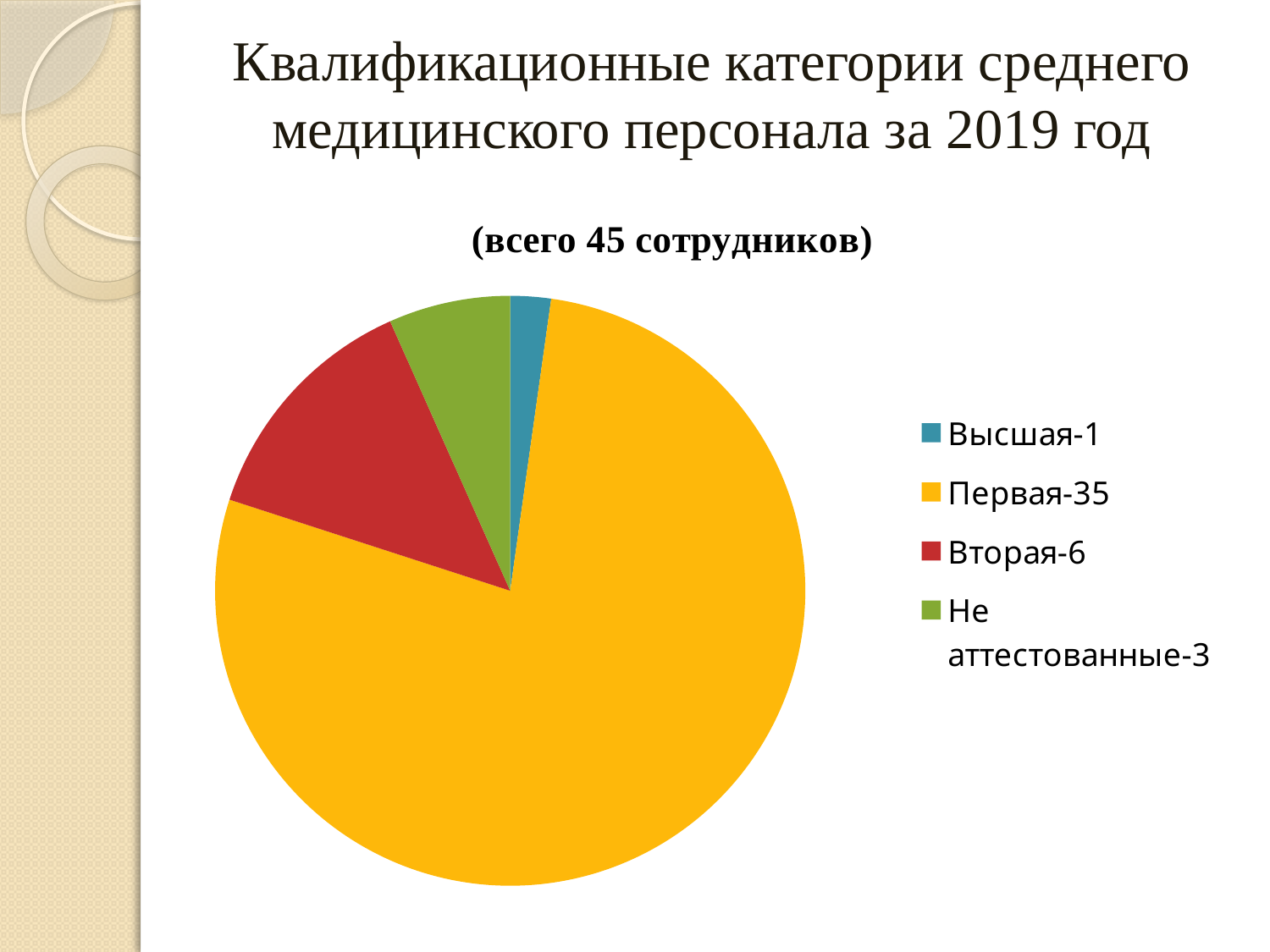
How many employees are in the Вторая category? 6 What colour is the slice for the Вторая category? red What is the difference between the Первая and Вторая values? 29 What is the total number of employees stated in the chart subtitle? 45 Which is larger, the Вторая value or the Не аттестованные value? Вторая How many employees are in the Высшая category? 1 What kind of chart is shown on the slide? pie chart How many employees are in the Первая category? 35 Which category has the largest slice of the pie? Первая How many employees are in the Не аттестованные category? 3 How many categories does the pie chart show? 4 Which category has the smallest slice of the pie? Высшая